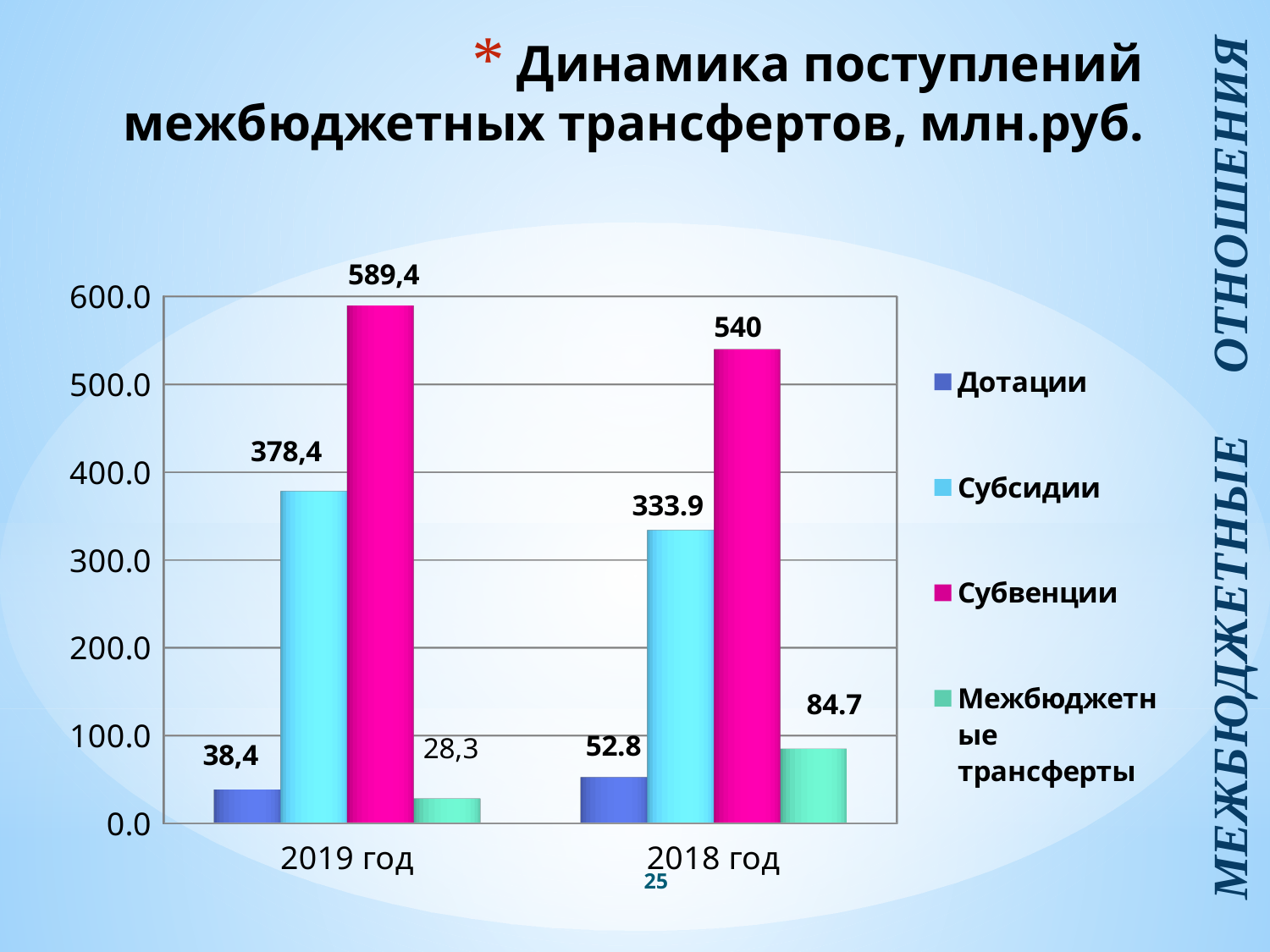
What is the difference between Субвенции and Субсидии in 2019 год? 211,0 Which series has the lowest value in 2019 год? Межбюджетные трансферты What is the value for Субвенции in 2019 год? 589,4 Which is larger: Дотации in 2019 год or Дотации in 2018 год? Дотации in 2018 год What colour are the bars for Субвенции? Pink (magenta) Which series has the highest value in 2018 год? Субвенции What is the difference between Субвенции and Субсидии in 2018 год? 206.1 What is the value for Субсидии in 2018 год? 333.9 What kind of chart is shown on the slide? Bar chart What is the value for Дотации in 2019 год? 38,4 What is the value for Межбюджетные трансферты in 2018 год? 84.7 How many series does the legend list? 4